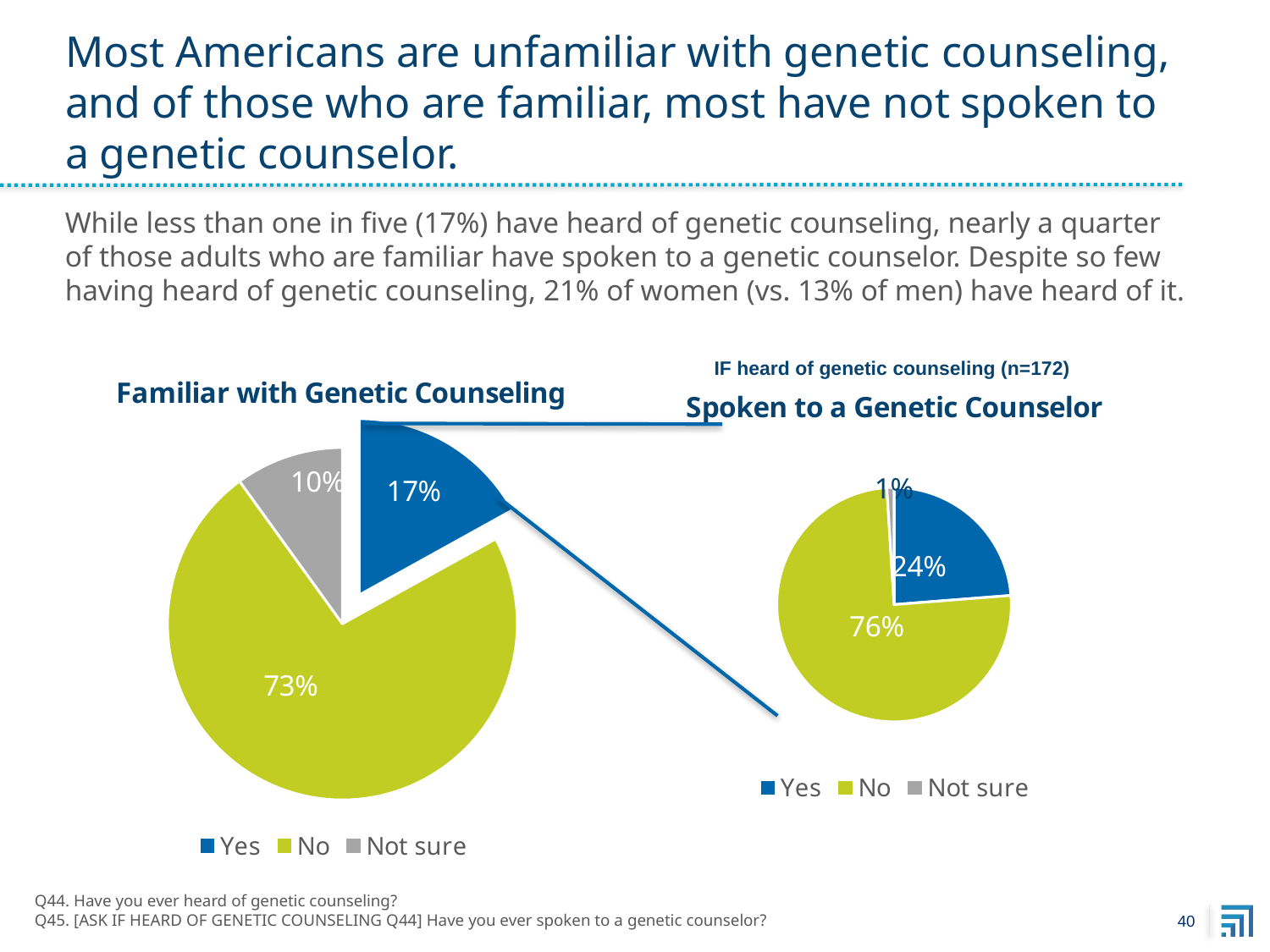
What type of chart is the 'Familiar with Genetic Counseling' chart? Pie chart In the 'Familiar with Genetic Counseling' chart, which response has the largest share? No In the 'Spoken to a Genetic Counselor' chart, what percentage answered Yes? 24% In the 'Familiar with Genetic Counseling' chart, what percentage answered Not sure? 10% In the 'Familiar with Genetic Counseling' chart, what percentage answered Yes? 17% In the 'Spoken to a Genetic Counselor' chart, what percentage answered No? 76% In the 'Familiar with Genetic Counseling' chart, what percentage answered No? 73% In the 'Spoken to a Genetic Counselor' chart, what percentage answered Not sure? 1% How many entries does the legend of the 'Spoken to a Genetic Counselor' chart list? 3 Which is larger in the 'Spoken to a Genetic Counselor' chart: the Yes share or the No share? No In the 'Familiar with Genetic Counseling' chart, what is the difference between the No and Yes shares? 56 percentage points In the 'Spoken to a Genetic Counselor' chart, which response has the smallest share? Not sure